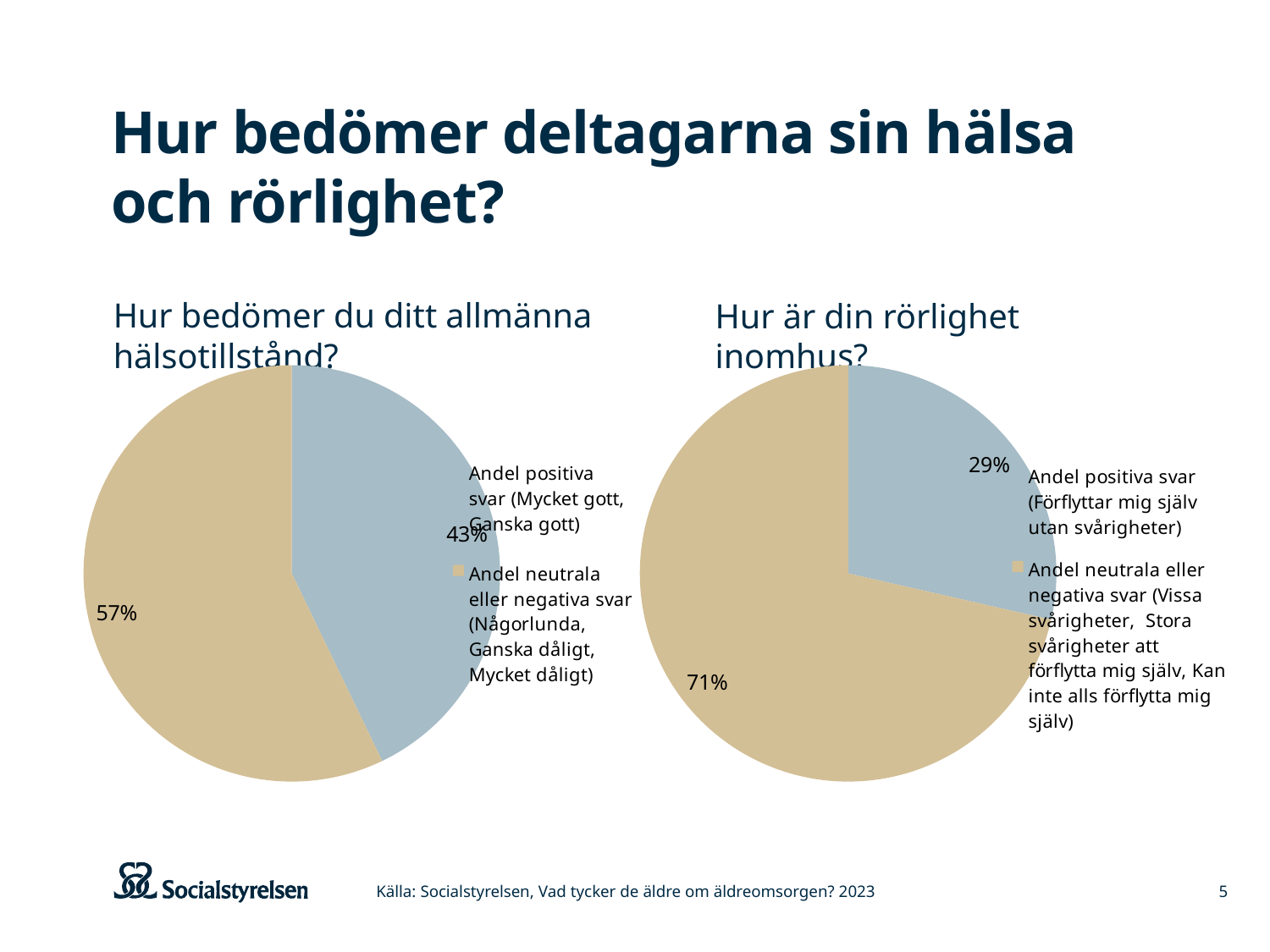
In the chart "Hur är din rörlighet inomhus?", which slice is the largest? Andel neutrala eller negativa svar Which chart has the larger share of positive answers, "Hur bedömer du ditt allmänna hälsotillstånd?" or "Hur är din rörlighet inomhus?"? Hur bedömer du ditt allmänna hälsotillstånd? In the chart "Hur är din rörlighet inomhus?", what share is "Andel neutrala eller negativa svar"? 71% How many slices does the chart "Hur är din rörlighet inomhus?" have? 2 In the chart "Hur bedömer du ditt allmänna hälsotillstånd?", what colour is the "Andel positiva svar" slice? Blue-grey In the chart "Hur är din rörlighet inomhus?", what is the difference between the neutral/negative share and the positive share? 42 percentage points In the chart "Hur bedömer du ditt allmänna hälsotillstånd?", what share is "Andel positiva svar"? 43% In the chart "Hur bedömer du ditt allmänna hälsotillstånd?", what is the difference between the neutral/negative share and the positive share? 14 percentage points In the chart "Hur bedömer du ditt allmänna hälsotillstånd?", which slice is the smallest? Andel positiva svar In the chart "Hur är din rörlighet inomhus?", what share is "Andel positiva svar"? 29% What kind of chart is used for "Hur bedömer du ditt allmänna hälsotillstånd?"? Pie chart